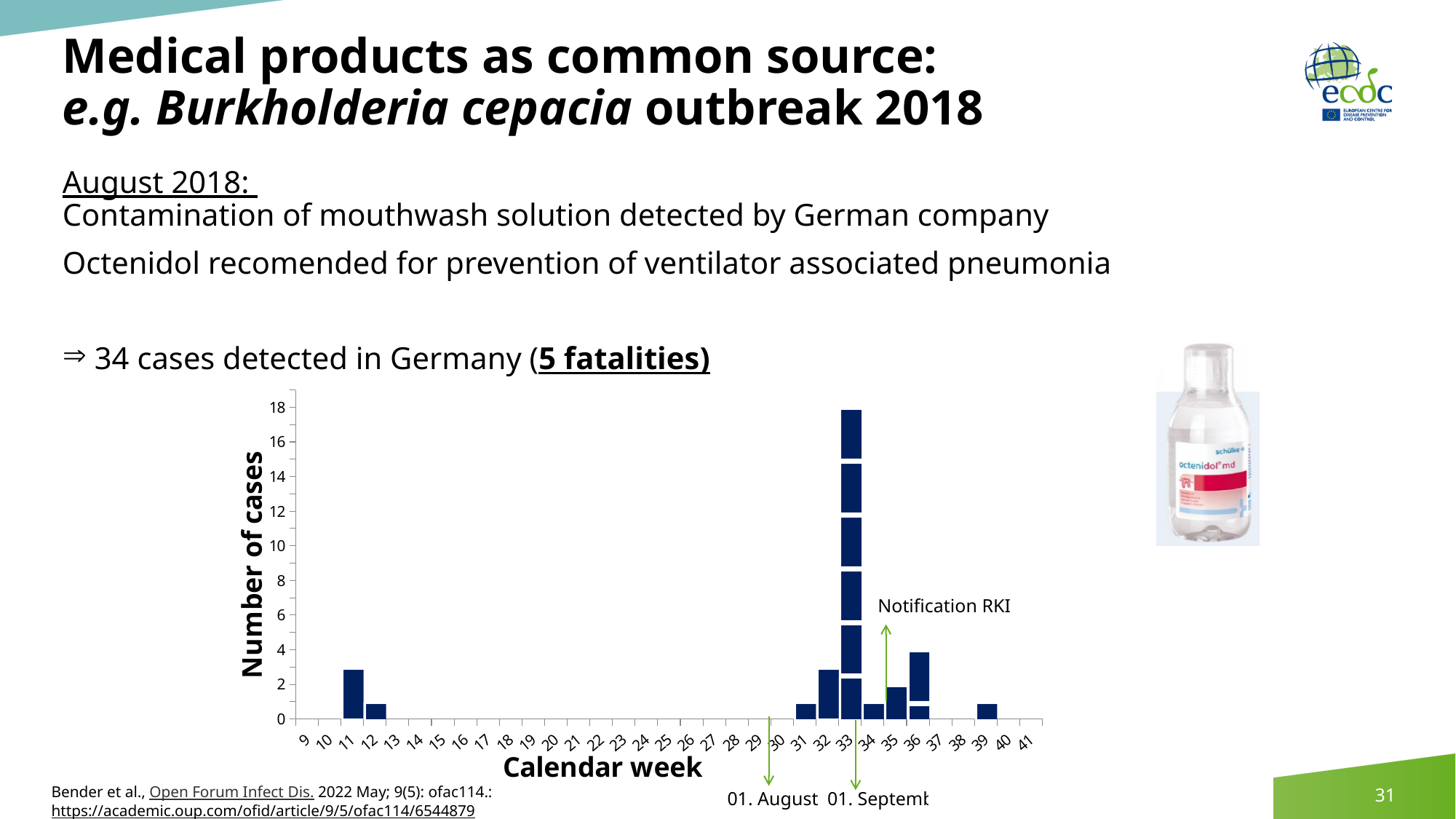
Which calendar week has the highest number of cases? 33 What is the label of the y axis? Number of cases What event is marked by the green arrow annotation above calendar week 34? Notification RKI How many calendar weeks have at least one case plotted? 9 Is the number of cases in calendar week 33 greater or less than 16? greater Is the number of cases in calendar week 11 greater or less than 2? greater Is the number of cases in calendar week 12 greater or less than 2? less How many calendar weeks are labelled on the x axis? 33 What kind of chart is shown on the slide? bar chart Which has more cases, calendar week 11 or calendar week 12? 11 Which has more cases, calendar week 33 or calendar week 36? 33